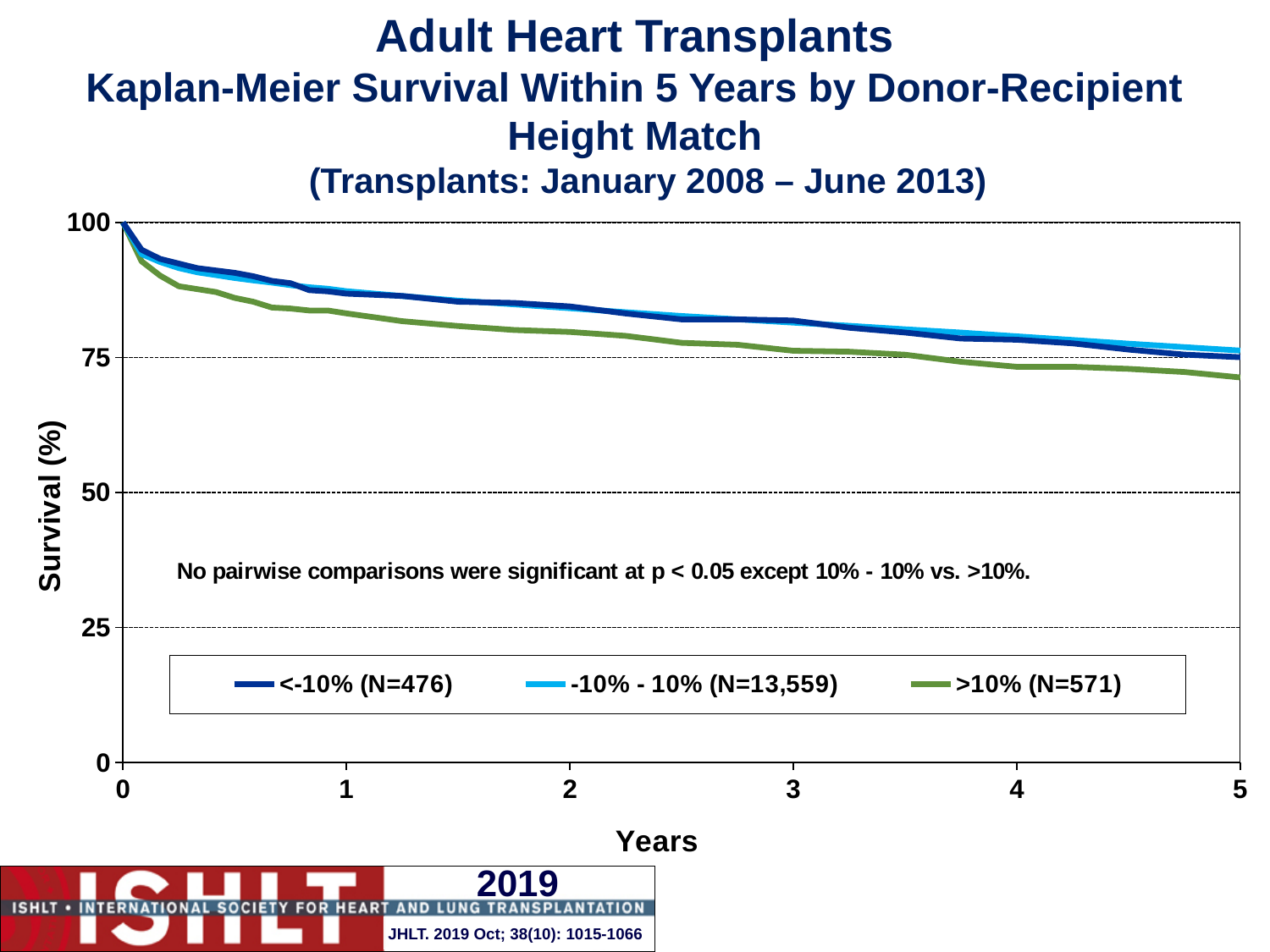
Which group has the lowest survival at 3 years? >10% (N=571) What is the N for the -10% - 10% group shown in the legend? 13,559 Is the survival for the <-10% group at 1 year greater or less than 75? greater What kind of chart is shown on the slide? Line chart Is the survival for the >10% group at 5 years greater or less than 75? less What is the N for the >10% group shown in the legend? 571 Do the survival curves rise or fall as years increase? Fall At 5 years, which group has higher survival: -10% - 10% or >10%? -10% - 10% How many series does the legend list? 3 Is the survival for the -10% - 10% group at 3 years greater or less than 75? greater What is the N for the <-10% group shown in the legend? 476 What is the label of the y axis? Survival (%)